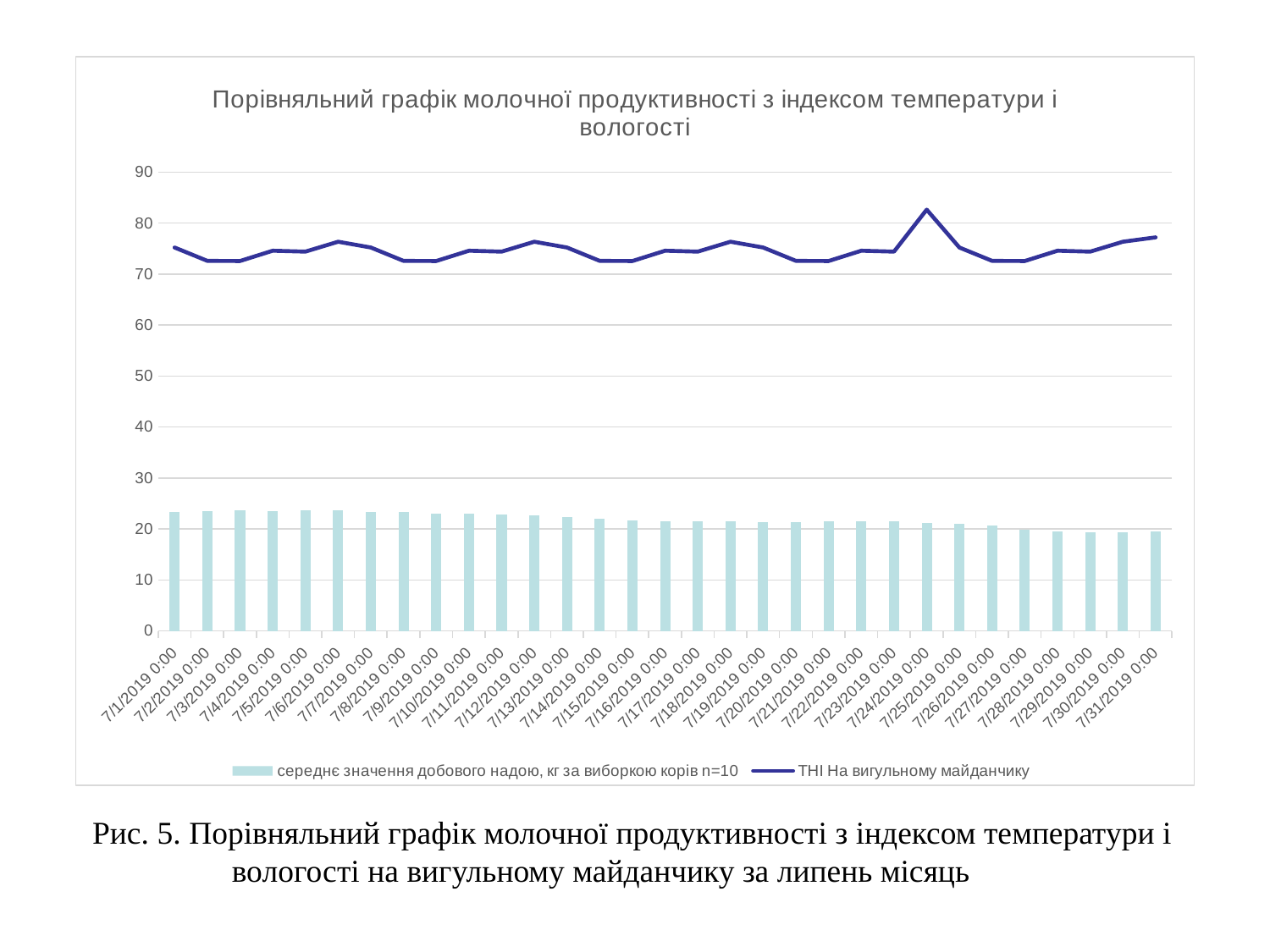
Is the average daily milk yield bar for 7/1/2019 0:00 greater or less than 20? greater On which date does the THI line (THI На вигульному майданчику) reach its highest value? 7/24/2019 0:00 Is the THI value on 7/24/2019 0:00 greater or less than 80? greater Which is larger, the milk yield bar for 7/1/2019 0:00 or for 7/31/2019 0:00? 7/1/2019 0:00 Is the THI value on 7/3/2019 0:00 greater or less than 70? greater Which series is drawn as a line rather than bars? THI На вигульному майданчику How many dates are plotted along the x axis? 31 Do the milk yield bars generally rise or fall from 7/1/2019 to 7/31/2019? fall What is the title of the chart? Порівняльний графік молочної продуктивності з індексом температури і вологості What kind of chart is shown on the slide? A combined bar and line chart How many series does the legend list? 2